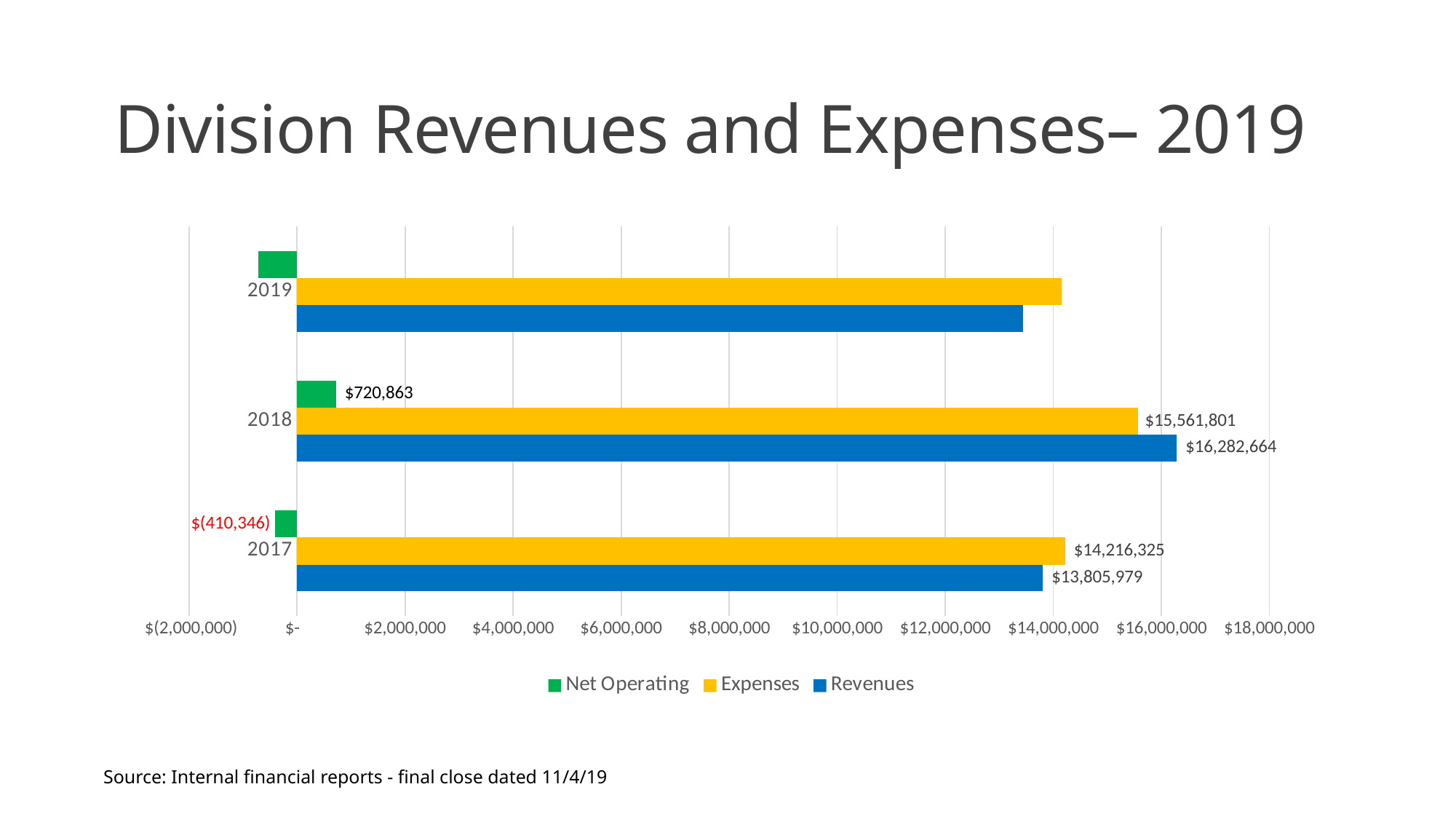
How many years are shown on the chart? 3 How many series does the legend list? 3 Is the value for Revenues in 2019 greater or less than $14,000,000? less What is the difference between Revenues and Expenses in 2018? $720,863 What kind of chart is shown on the slide? bar chart What was the Net Operating value in 2018? $720,863 What was the Net Operating value in 2017? $(410,346) In 2017, which was larger, Revenues or Expenses? Expenses What were the Expenses in 2017? $14,216,325 What were the Revenues in 2018? $16,282,664 Which series is shown in green in the legend? Net Operating Which year had the highest Revenues? 2018